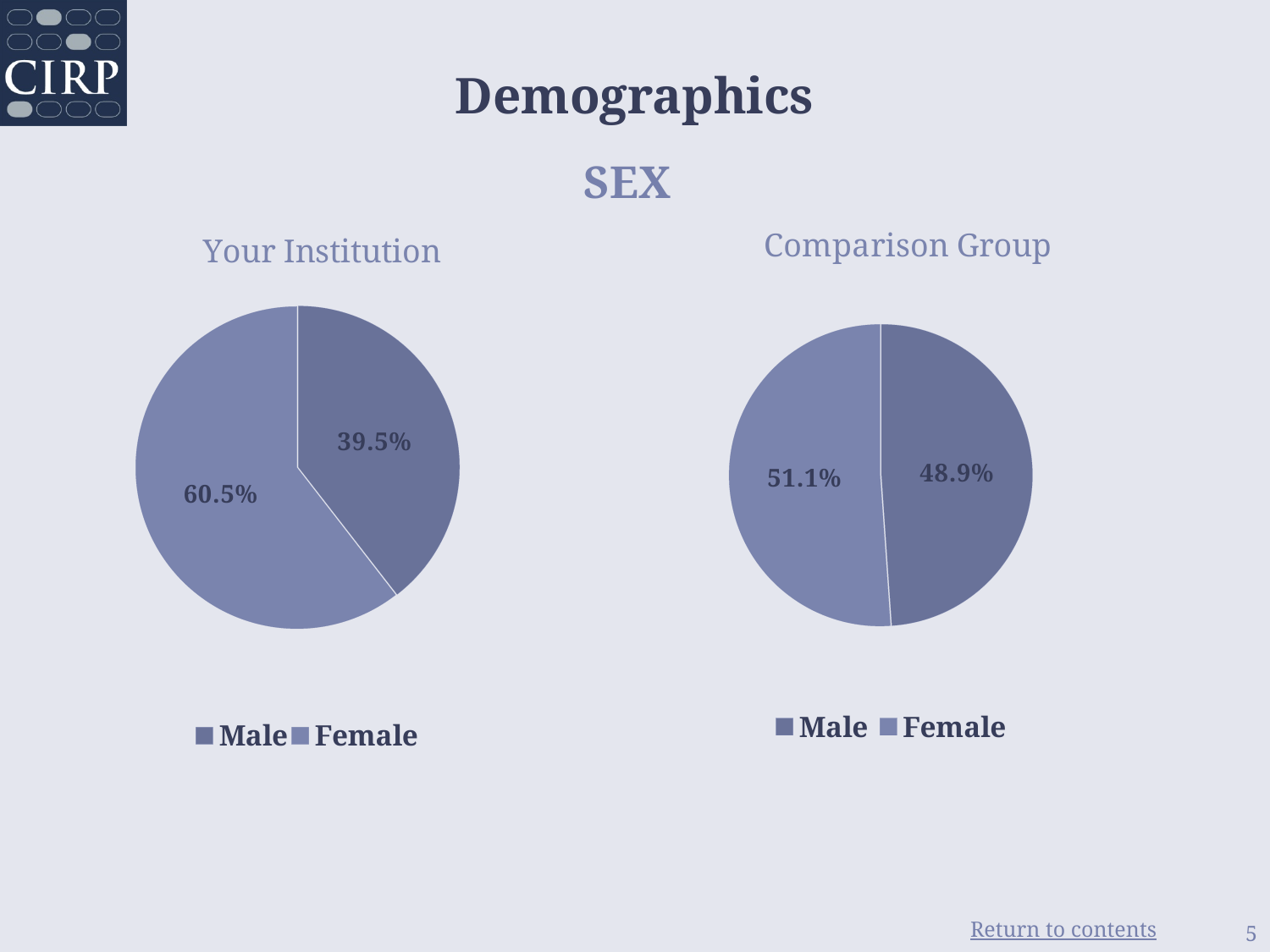
In the 'Comparison Group' pie chart, what percentage is Female? 51.1% In the 'Your Institution' pie chart, which category has the larger share? Female In the 'Your Institution' pie chart, what percentage is Male? 39.5% In the 'Comparison Group' pie chart, what is the difference between the Female and Male percentages? 2.2% In the 'Your Institution' pie chart, what is the difference between the Female and Male percentages? 21.0% Is the Male share larger in the 'Your Institution' chart or the 'Comparison Group' chart? Comparison Group In the 'Your Institution' pie chart, which category has the smaller share? Male In the 'Comparison Group' pie chart, what percentage is Male? 48.9% In the 'Your Institution' pie chart, what percentage is Female? 60.5% What type of chart is used for 'Your Institution'? Pie chart How many slices does the 'Comparison Group' pie chart have? 2 How many entries does the legend of the 'Your Institution' chart list? 2